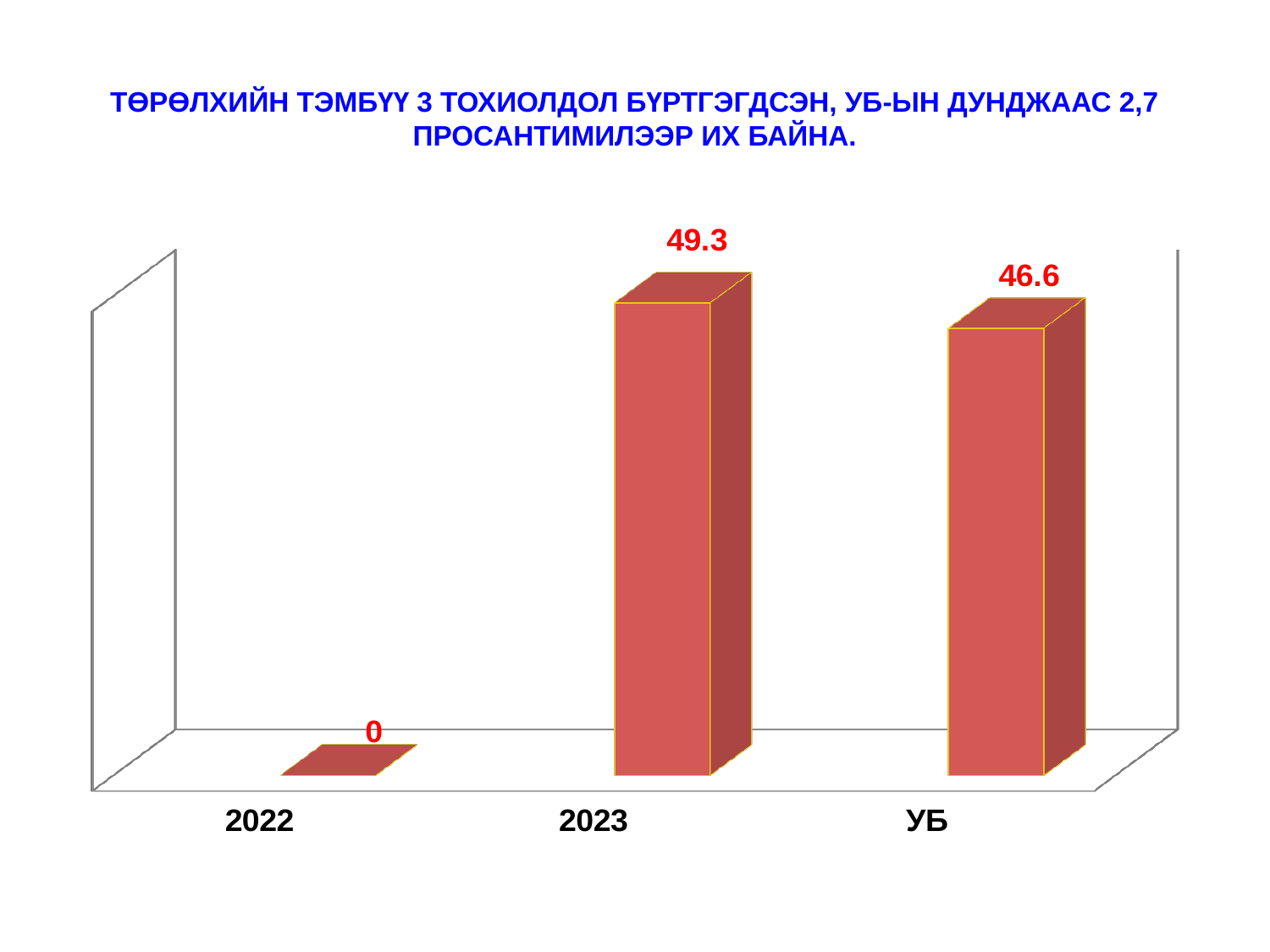
How many categories are shown on the x axis? 3 Which category has the highest value? 2023 What is the value for УБ? 46.6 What is the value for 2023? 49.3 What is the difference between the values for 2023 and 2022? 49.3 What is the value for 2022? 0 Which is larger, the value for 2023 or the value for УБ? 2023 What kind of chart is shown on the slide? bar chart Which category has the lowest value? 2022 What is the difference between the values for 2023 and УБ? 2.7 Does the value rise or fall from 2022 to 2023? rise What colour are the bars in the chart? red